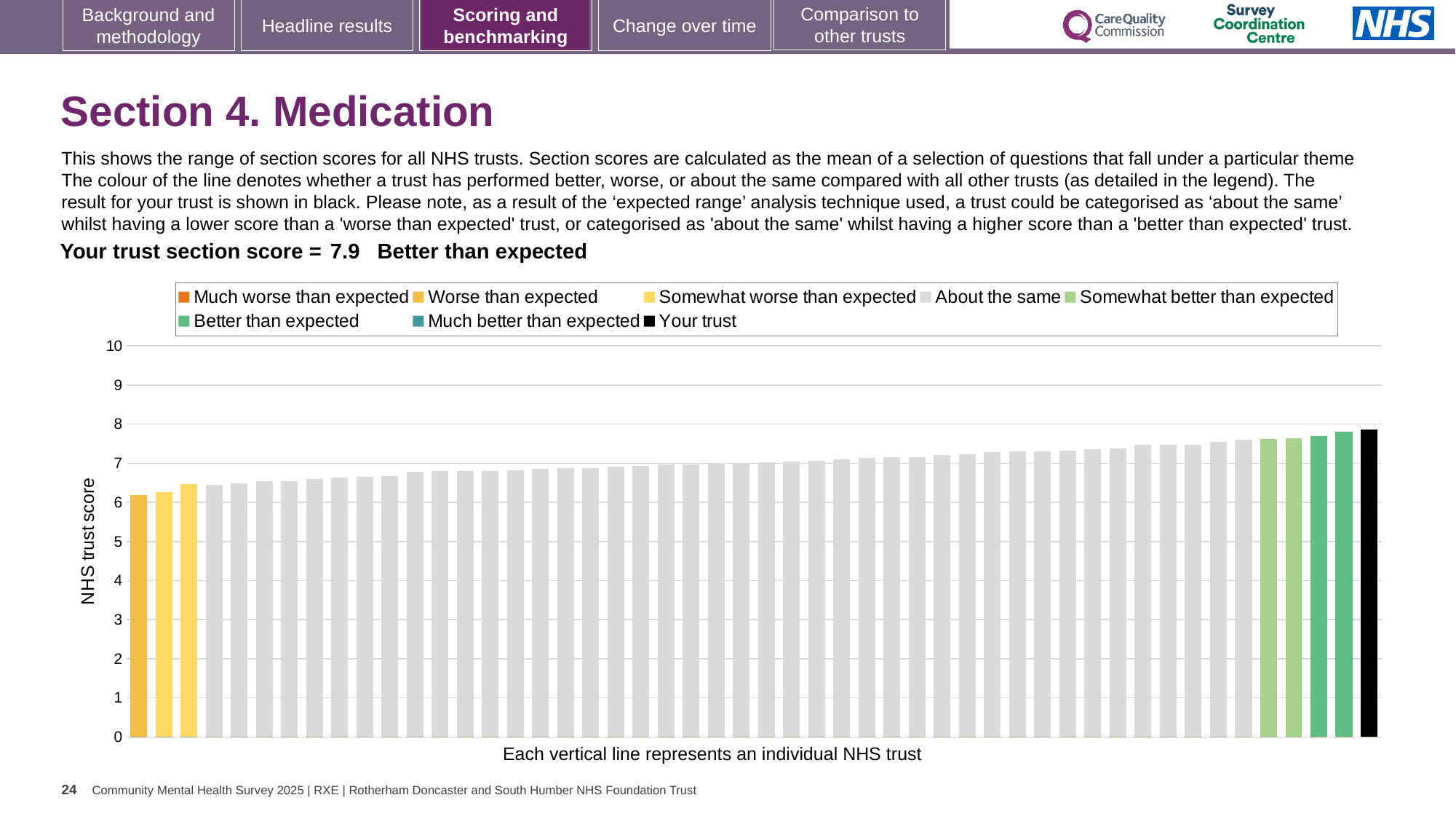
What colour is used for the 'Your trust' bar according to the legend? black What category does the slide say your trust falls into for this section? Better than expected Which is larger: the black 'Your trust' bar or the leftmost bar? the black 'Your trust' bar What kind of chart is shown on the slide? bar chart What is the title of the vertical axis? NHS trust score Is the value of the leftmost bar greater or less than 5? greater What is the section score for your trust shown on the slide? 7.9 Is the value of the leftmost bar greater or less than 7? less Is the value of the black 'Your trust' bar greater or less than 7? greater Which bar is the highest in the chart? Your trust (the black bar) Do the bar values rise or fall from left to right along the x axis? rise How many entries does the chart legend list? 8